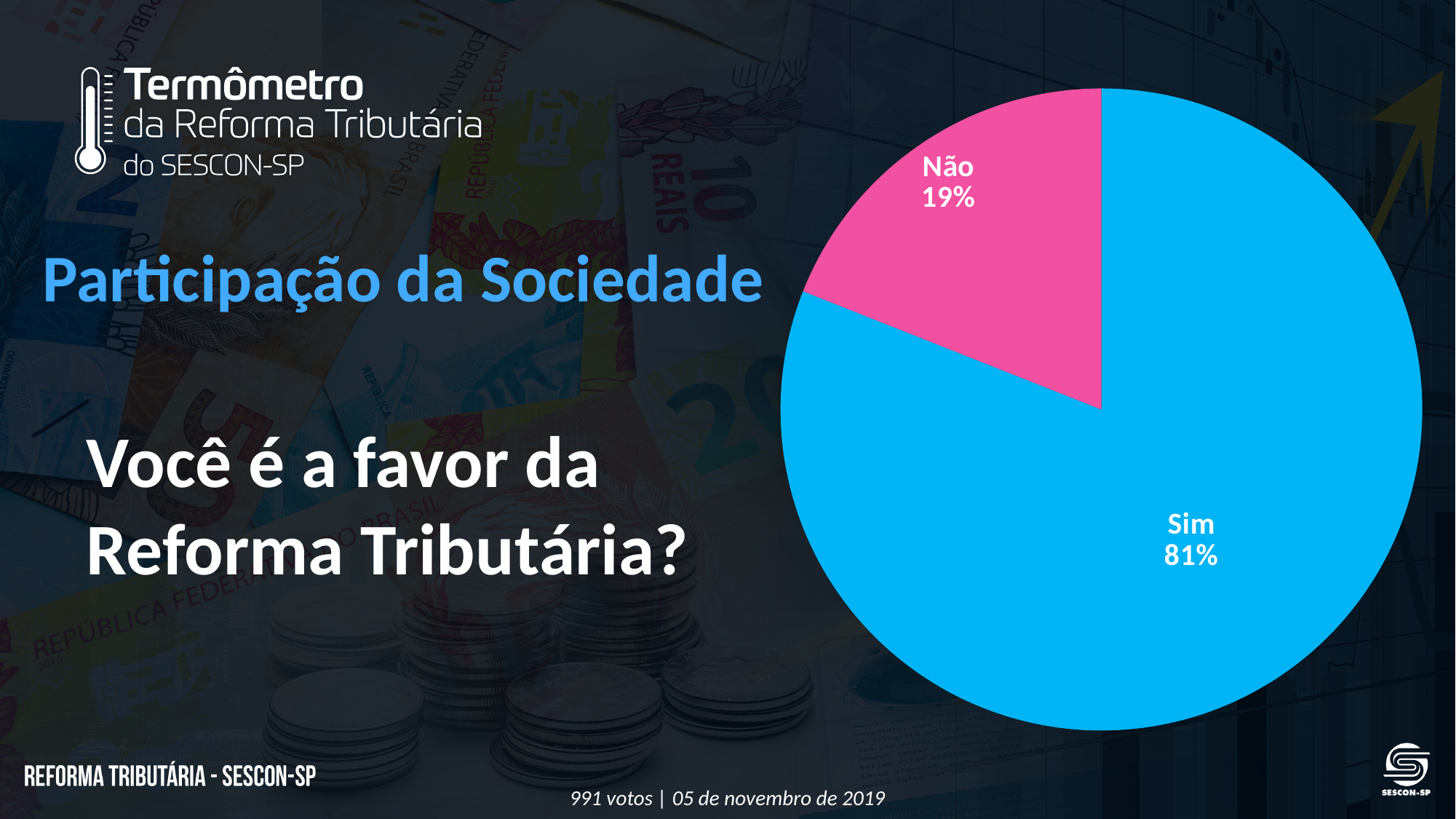
What is the difference in percentage points between the "Sim" and "Não" slices? 62 What kind of chart is shown on the slide? pie chart How many votes does the slide say the chart is based on? 991 votos Which is larger, the "Sim" slice or the "Não" slice? Sim What percentage of respondents answered "Não"? 19% What percentage of respondents answered "Sim"? 81% How many slices does the pie chart have? 2 What share of the pie does the "Não" slice represent? 19% Which slice of the pie chart is the largest? Sim What colour is the "Sim" slice of the pie chart? blue Which slice of the pie chart is the smallest? Não